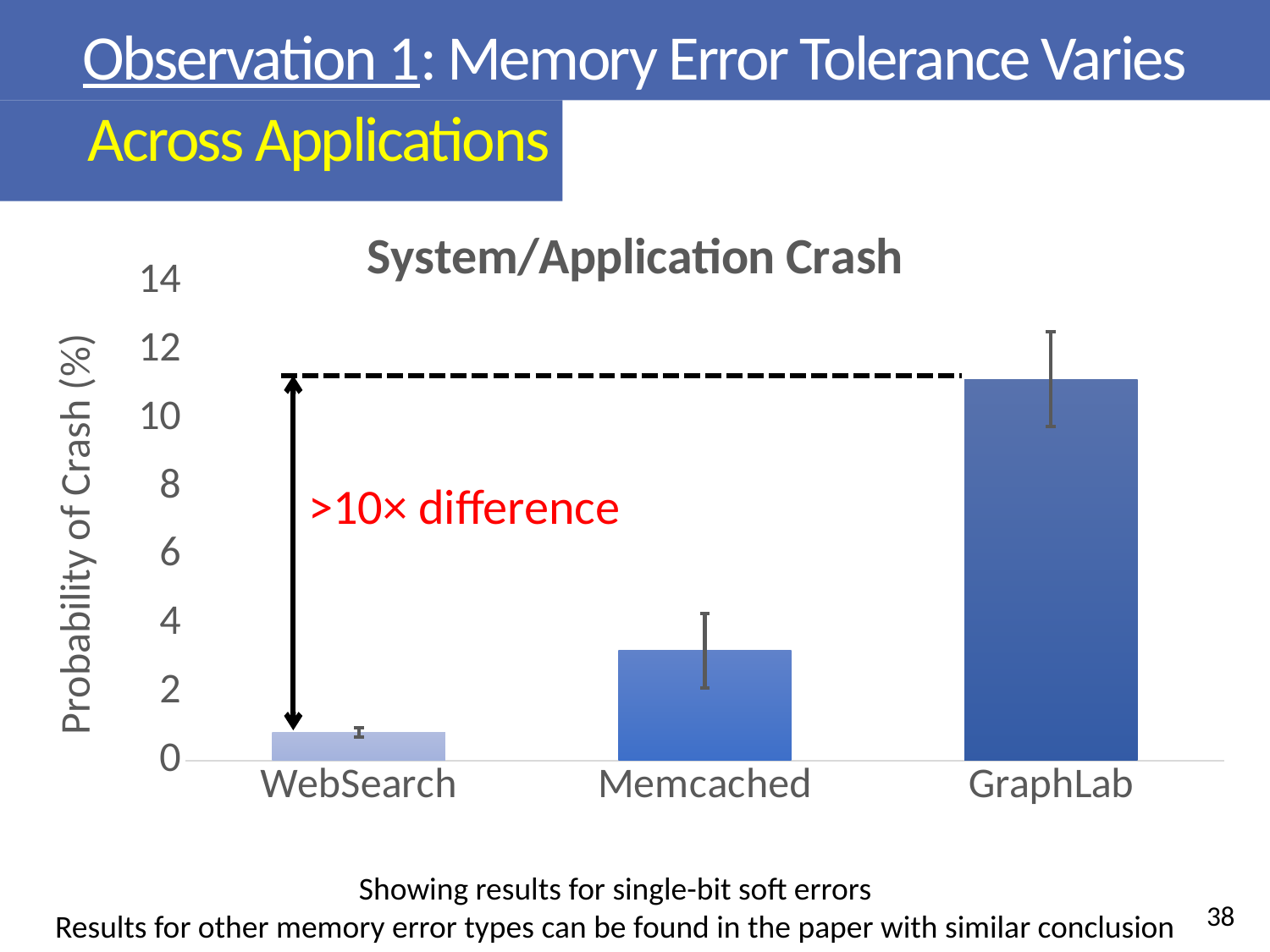
Which has a higher probability of crash, Memcached or WebSearch? Memcached What is the title of the chart? System/Application Crash Is the value for GraphLab greater or less than 10? greater Is the value for Memcached greater or less than 4? less How many applications (categories) are plotted in the chart? 3 Do the bar values rise or fall from WebSearch to GraphLab along the x axis? rise Which has a higher probability of crash, GraphLab or Memcached? GraphLab What is the label of the vertical axis? Probability of Crash (%) Which application has the lowest probability of crash? WebSearch Which application has the highest probability of crash? GraphLab What kind of chart is shown on the slide? bar chart Is the value for WebSearch greater or less than 2? less